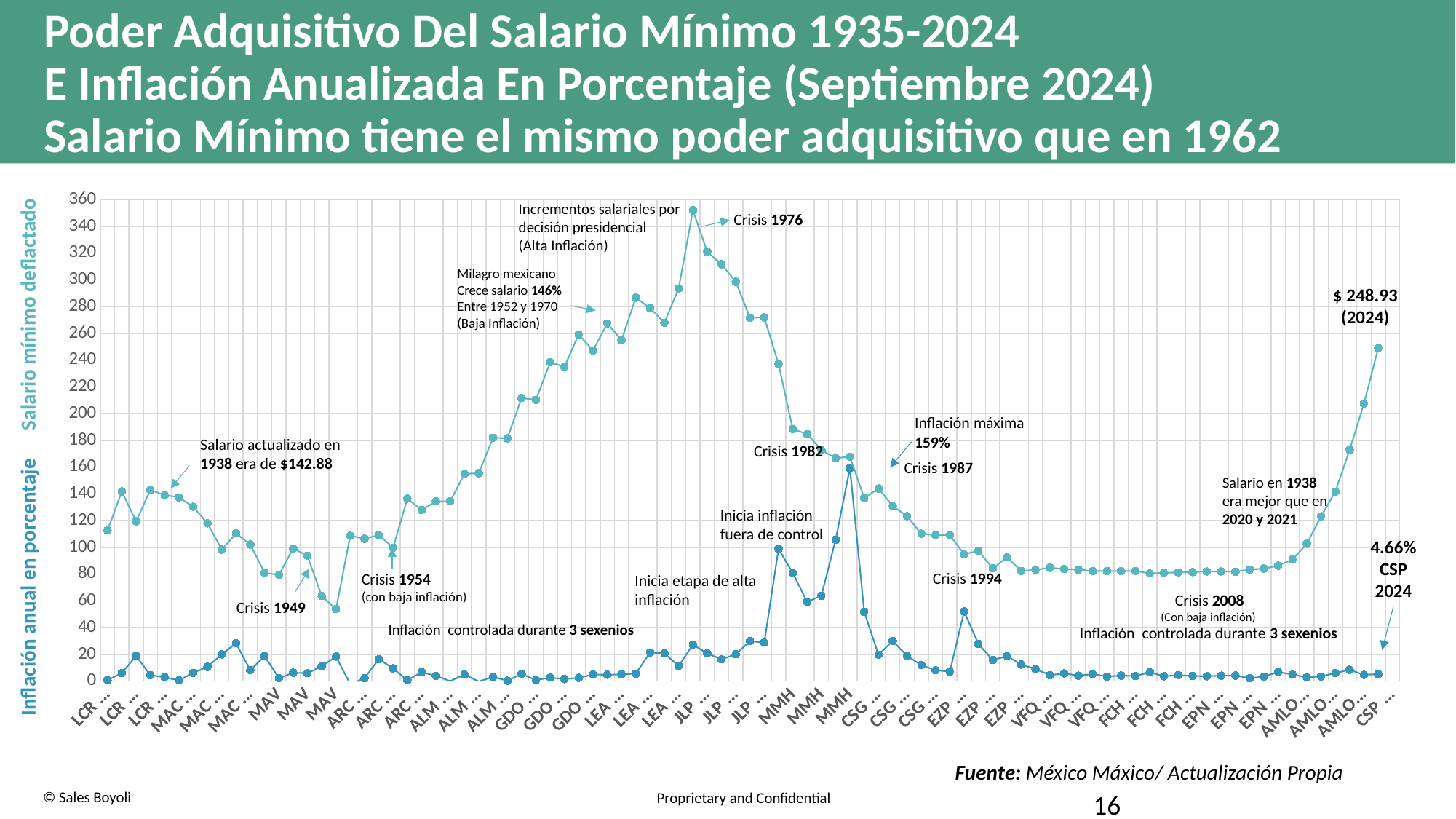
What annual inflation percentage is shown for CSP 2024? 4.66% Is the peak value of the deflated minimum wage at Crisis 1976 greater or less than 340? greater Between Crisis 1976 and Crisis 1982, does the deflated minimum wage rise or fall? fall According to the annotation, what was the updated minimum wage in 1938? $142.88 How many data series are plotted on the chart? 2 What is the maximum inflation value annotated on the chart? 159% In which year does the deflated minimum wage reach its peak, according to the annotation at the highest point? 1976 What source is cited for the chart? México Máxico/ Actualización Propia What kind of chart is shown on the slide? line chart What is the difference between the deflated minimum wage in 2024 ($248.93) and in 1938 ($142.88)? $106.05 What is the deflated minimum wage value shown for 2024? $ 248.93 Which is larger: the deflated minimum wage in 1938 ($142.88) or in 2024 ($248.93)? 2024